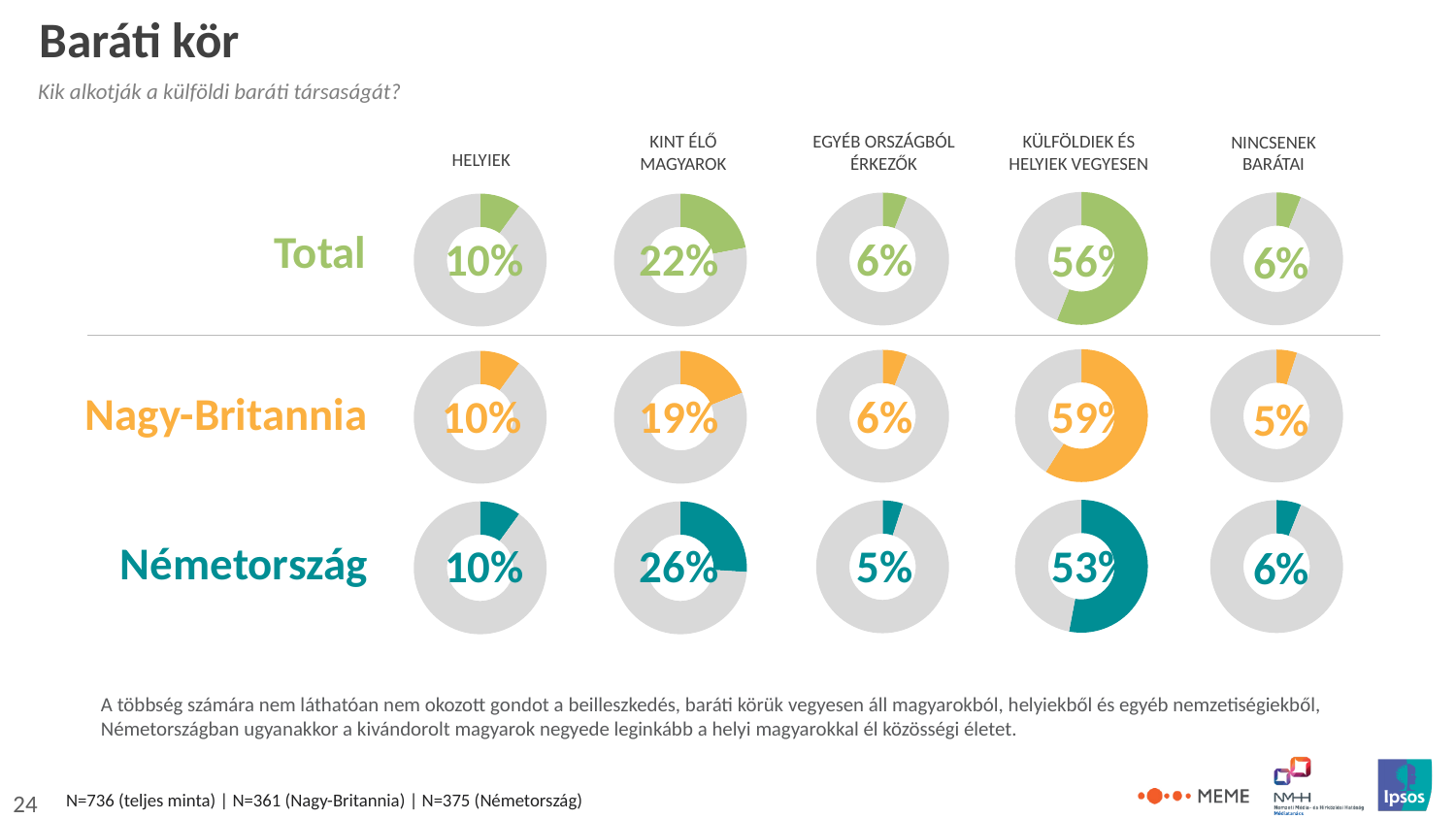
In the Németország row, what percentage is shown in the donut chart for 'Kint élő magyarok'? 26% In the Total row, what percentage is shown in the donut chart for 'Kint élő magyarok'? 22% In the Nagy-Britannia row, what percentage is shown in the donut chart for 'Külföldiek és helyiek vegyesen'? 59% In the Total row, which category has the highest percentage? Külföldiek és helyiek vegyesen In the Nagy-Britannia row, what percentage is shown in the donut chart for 'Nincsenek barátai'? 5% What colour are the donut charts in the Németország row? Teal What is the title of the slide? Baráti kör For the 'Külföldiek és helyiek vegyesen' column, which row has the larger value: Nagy-Britannia or Németország? Nagy-Britannia In the Németország row, which category has the lowest percentage? Egyéb országból érkezők For the 'Kint élő magyarok' column, what is the difference between the Németország value and the Nagy-Britannia value? 7% What type of chart is used to display the percentages on this slide? Donut (pie) chart How many donut charts are shown in each row of the slide? 5